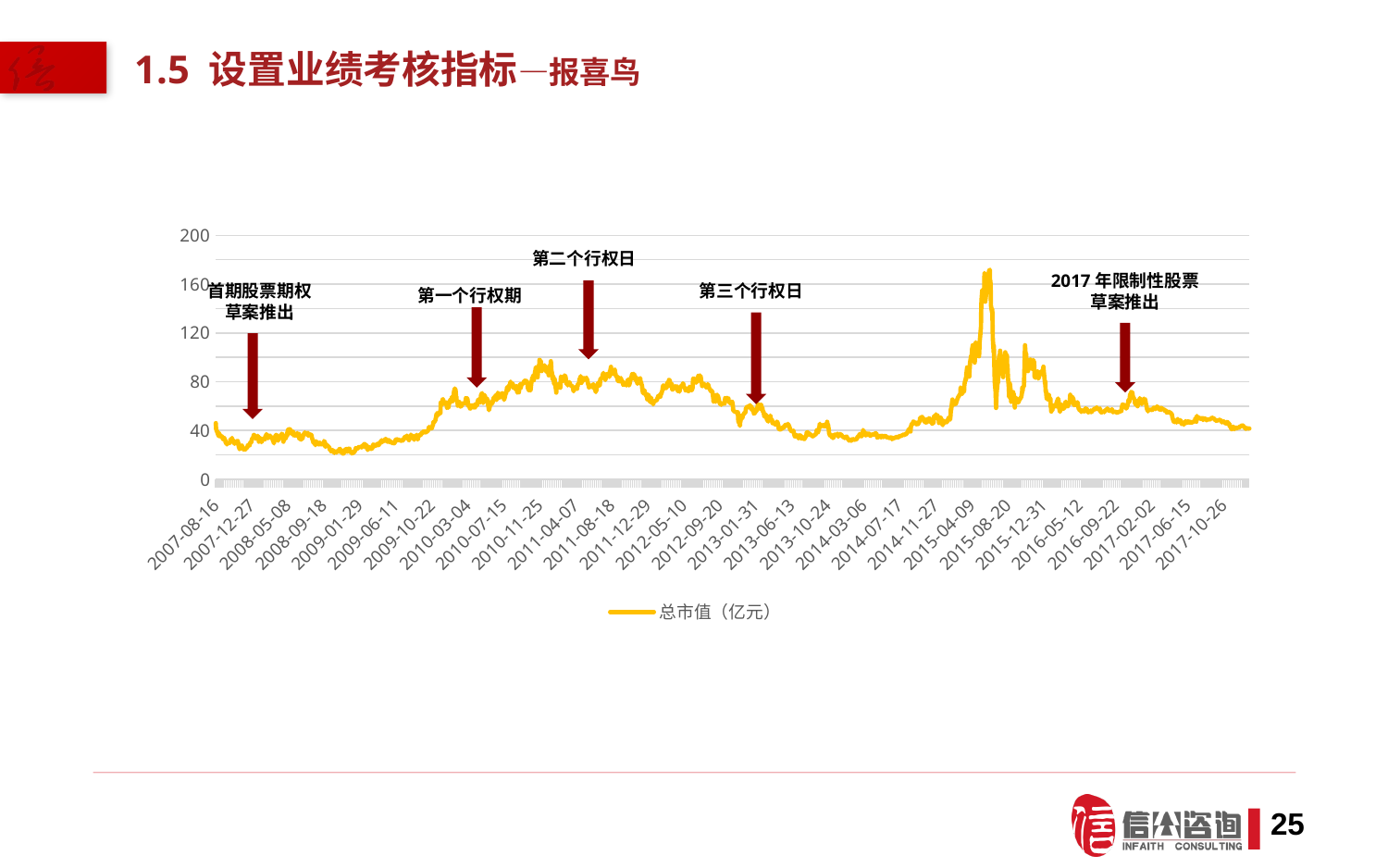
Does the value of 总市值 rise or fall between 2009-01-29 and 2010-11-25? rise What kind of chart is shown on the slide? line chart Is the value of 总市值 around 2012-05-10 greater or less than 120? less How many series does the legend list? 1 What is the series name shown in the legend? 总市值（亿元） How many annotated events (red arrows) are marked on the chart? 5 Is the value of 总市值 around 2009-01-29 greater or less than 40? less Is the value of 总市值 around 2015-04-09 larger or smaller than the value around 2013-10-24? larger Is the highest value of 总市值 on the chart greater or less than 160? greater Does the value of 总市值 rise or fall between 2015-08-20 and 2017-10-26? fall What is the highest value shown on the y axis? 200